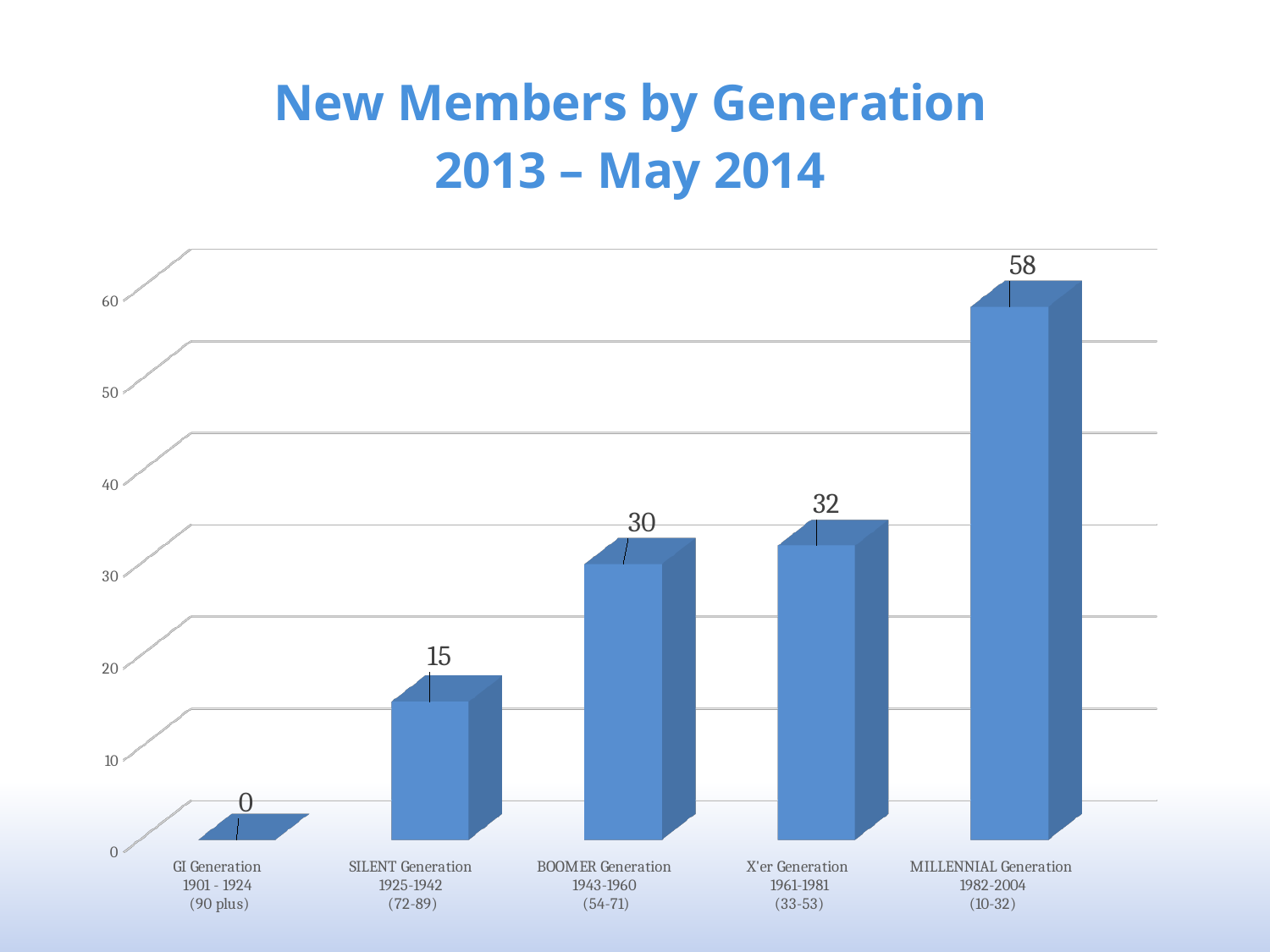
What kind of chart is shown on the slide? Bar chart What is the value shown for the BOOMER Generation? 30 What is the value shown for the SILENT Generation? 15 Which is larger, the value for the X'er Generation or the BOOMER Generation? X'er Generation Which generation has the lowest number of new members? GI Generation What is the difference between the BOOMER Generation and the SILENT Generation values? 15 Which generation has the highest number of new members? MILLENNIAL Generation How many generation categories are shown on the chart? 5 What is the difference between the MILLENNIAL Generation and the X'er Generation values? 26 How many new members does the chart show for the MILLENNIAL Generation? 58 Do the values rise or fall moving from left to right across the generations? Rise What is the value shown for the GI Generation? 0